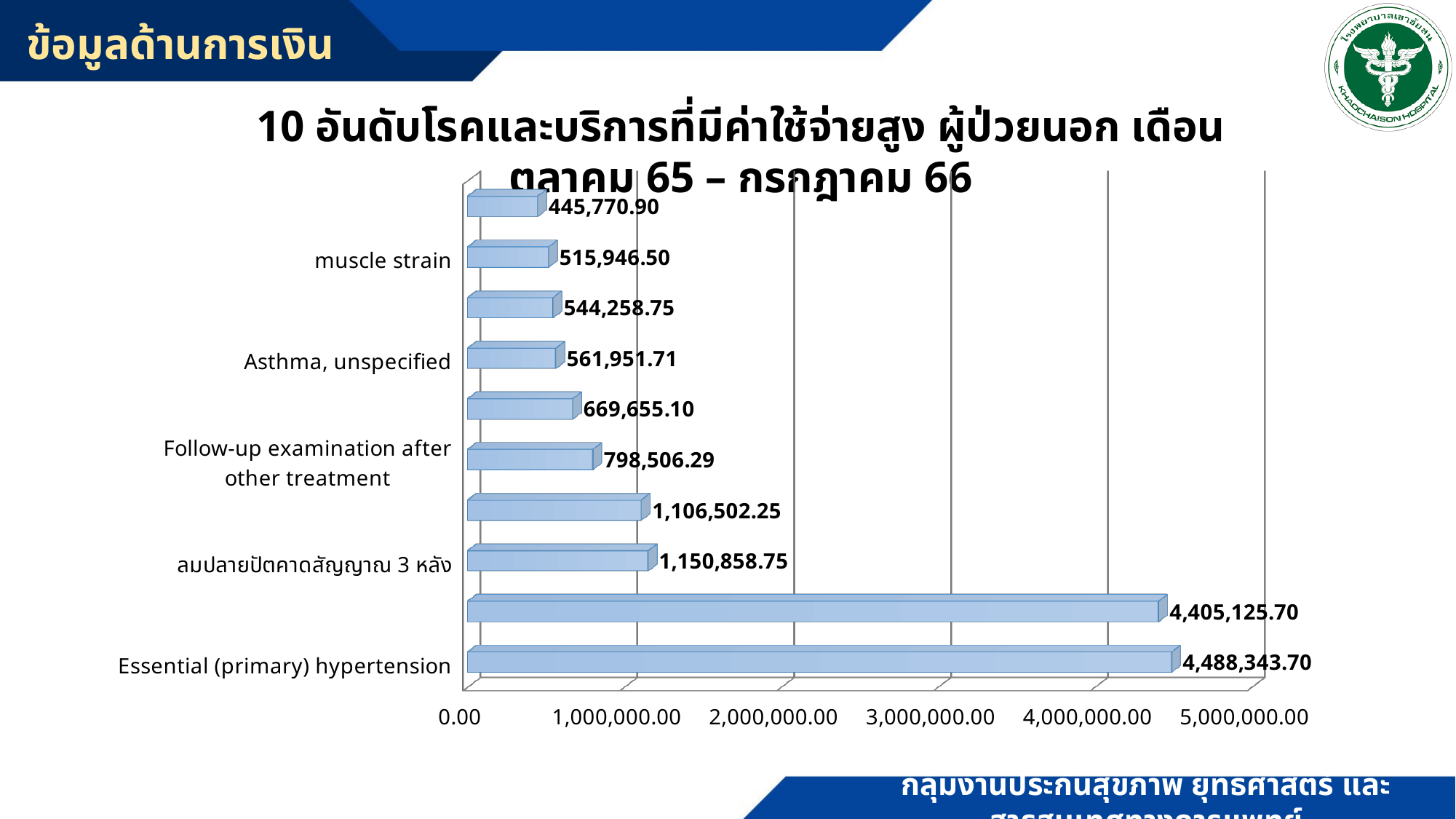
What is the value for muscle strain? 515,946.50 How many bars are plotted in the chart? 10 Is the value for muscle strain greater or less than 1,000,000.00? less Which is larger: the value for Follow-up examination after other treatment or the value for Asthma, unspecified? Follow-up examination after other treatment What is the value for Essential (primary) hypertension? 4,488,343.70 Which category has the highest value? Essential (primary) hypertension What is the smallest value shown on any bar in the chart? 445,770.90 What is the value for Follow-up examination after other treatment? 798,506.29 What is the value for Asthma, unspecified? 561,951.71 What is the value for ลมปลายปัตคาดสัญญาณ 3 หลัง? 1,150,858.75 What is the difference between the values for Essential (primary) hypertension and ลมปลายปัตคาดสัญญาณ 3 หลัง? 3,337,484.95 What type of chart is shown on the slide? bar chart